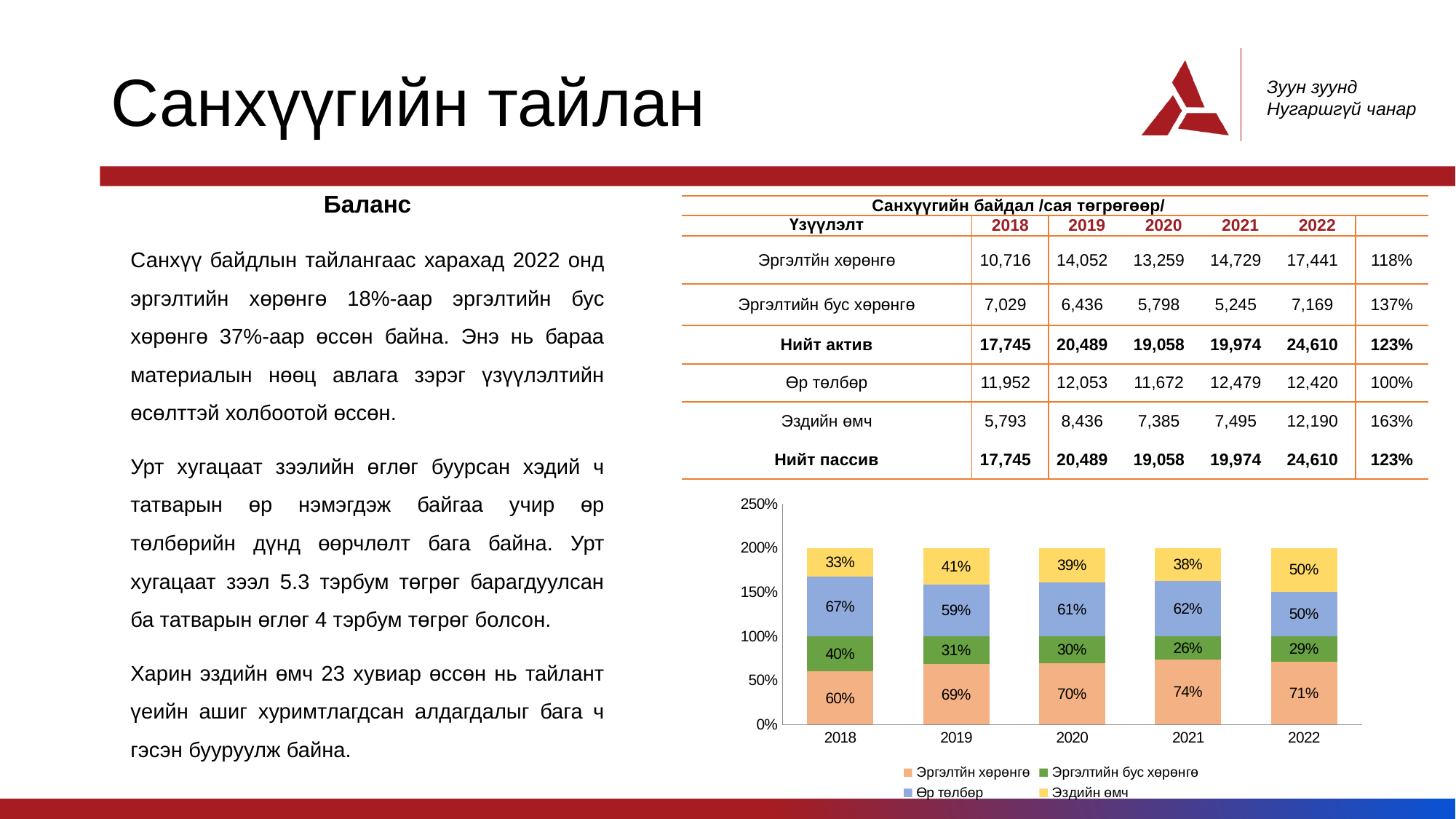
In which year is Эргэлтийн бус хөрөнгө highest in the chart? 2018 In which year is Өр төлбөр lowest in the chart? 2022 What is the total of the stacked bar for 2020 in the chart? 200% Which is larger in the chart: Эргэлтйн хөрөнгө in 2019 or in 2020? 2020 How many series does the chart legend list? 4 How many years are shown on the x axis of the chart? 5 What is the difference between Эздийн өмч in 2022 and in 2018 in the chart? 17% What is the value of Эргэлтйн хөрөнгө for 2021 in the chart? 74% What is the value of Өр төлбөр for 2018 in the chart? 67% What kind of chart is shown on the slide? Stacked bar chart Does Эргэлтийн бус хөрөнгө rise or fall from 2018 to 2021 in the chart? Fall What is the value of Эздийн өмч for 2022 in the chart? 50%